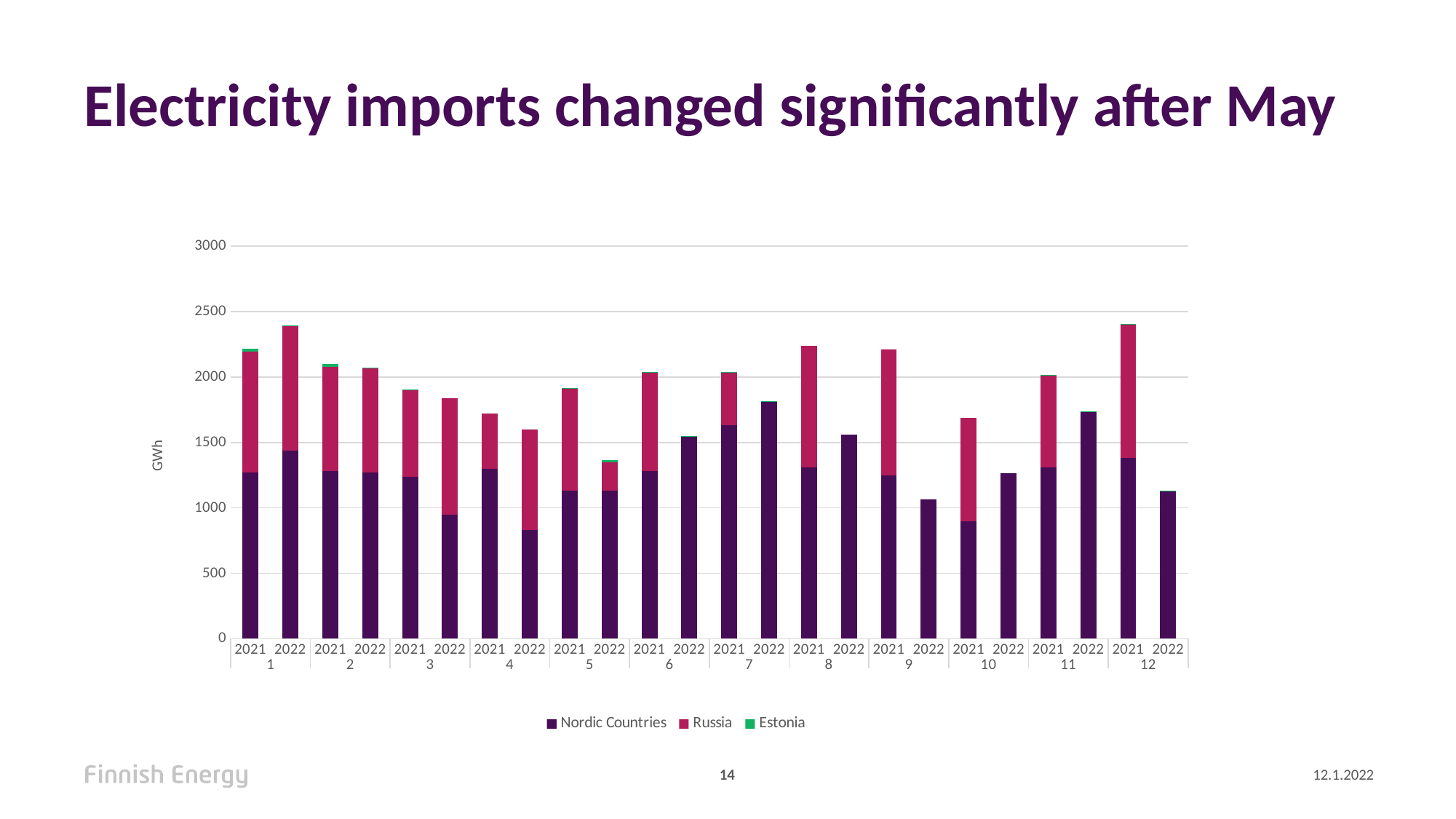
Is the total value for 2021 in month 12 greater or less than 2000? greater What unit is shown on the vertical axis? GWh Is the total value for 2022 in month 7 greater or less than 2000? less Which series are listed in the legend? Nordic Countries, Russia, Estonia How many series does the legend list? 3 Is the total value for 2022 in month 5 greater or less than 1500? less How many bars are plotted in the chart? 24 What type of chart is shown on the slide? stacked bar chart Which is larger, the total for 2022 in month 7 or the total for 2022 in month 8? 2022 in month 7 Which is larger, the total for 2021 in month 1 or the total for 2022 in month 1? 2022 in month 1